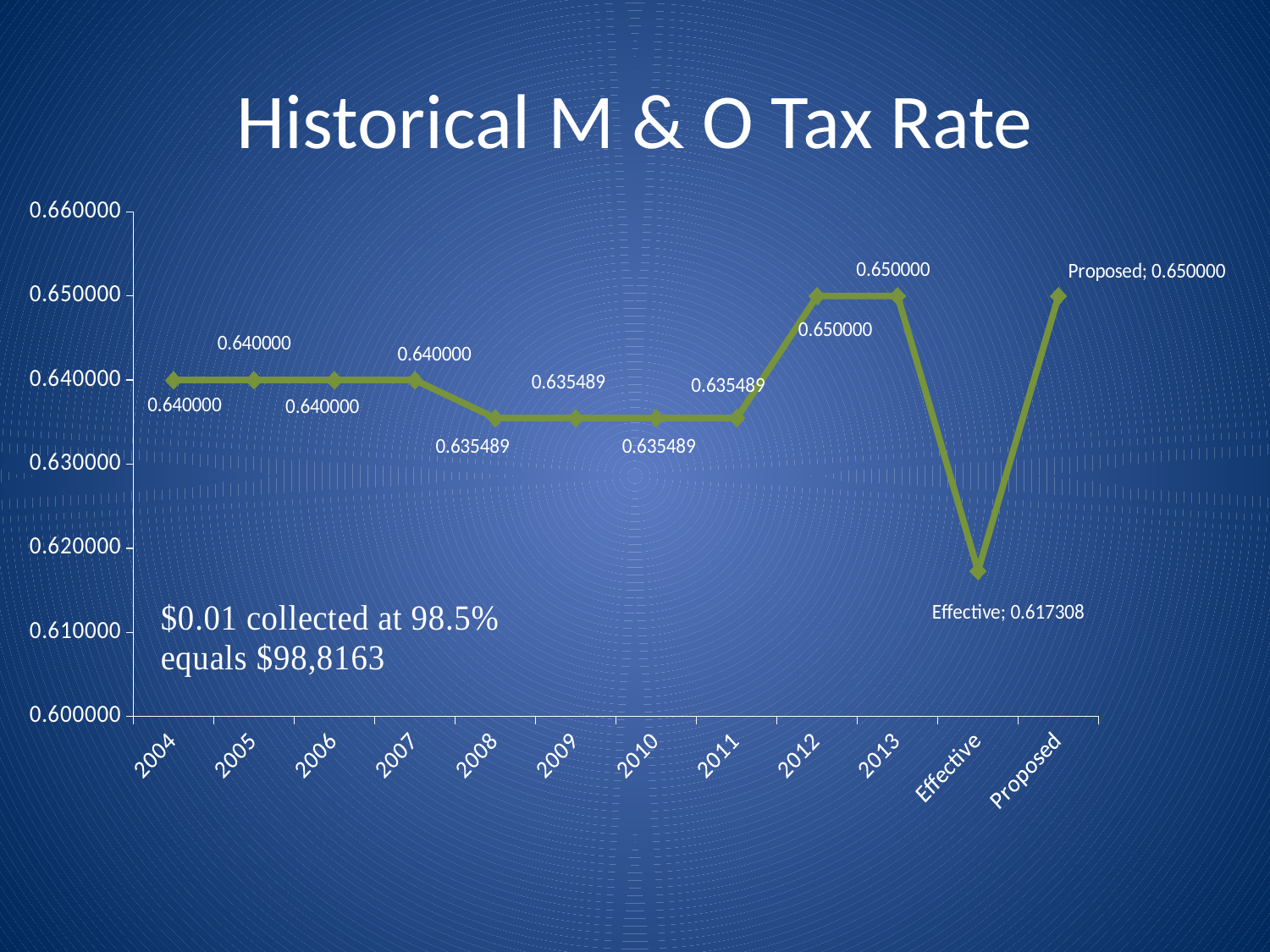
Does the value rise or fall from 2011 to 2012? rise Which is larger, the value for 2007 or the value for 2008? 2007 How many data points are plotted along the x axis? 12 What is the tax rate value for 2009? 0.635489 What is the title of the chart? Historical M & O Tax Rate What is the difference between the Proposed value and the Effective value? 0.032692 What is the value labelled Proposed? 0.650000 What is the value labelled Effective? 0.617308 What is the tax rate value for 2004? 0.640000 Which category has the lowest value on the chart? Effective What kind of chart is shown on the slide? line chart What is the tax rate value for 2012? 0.650000